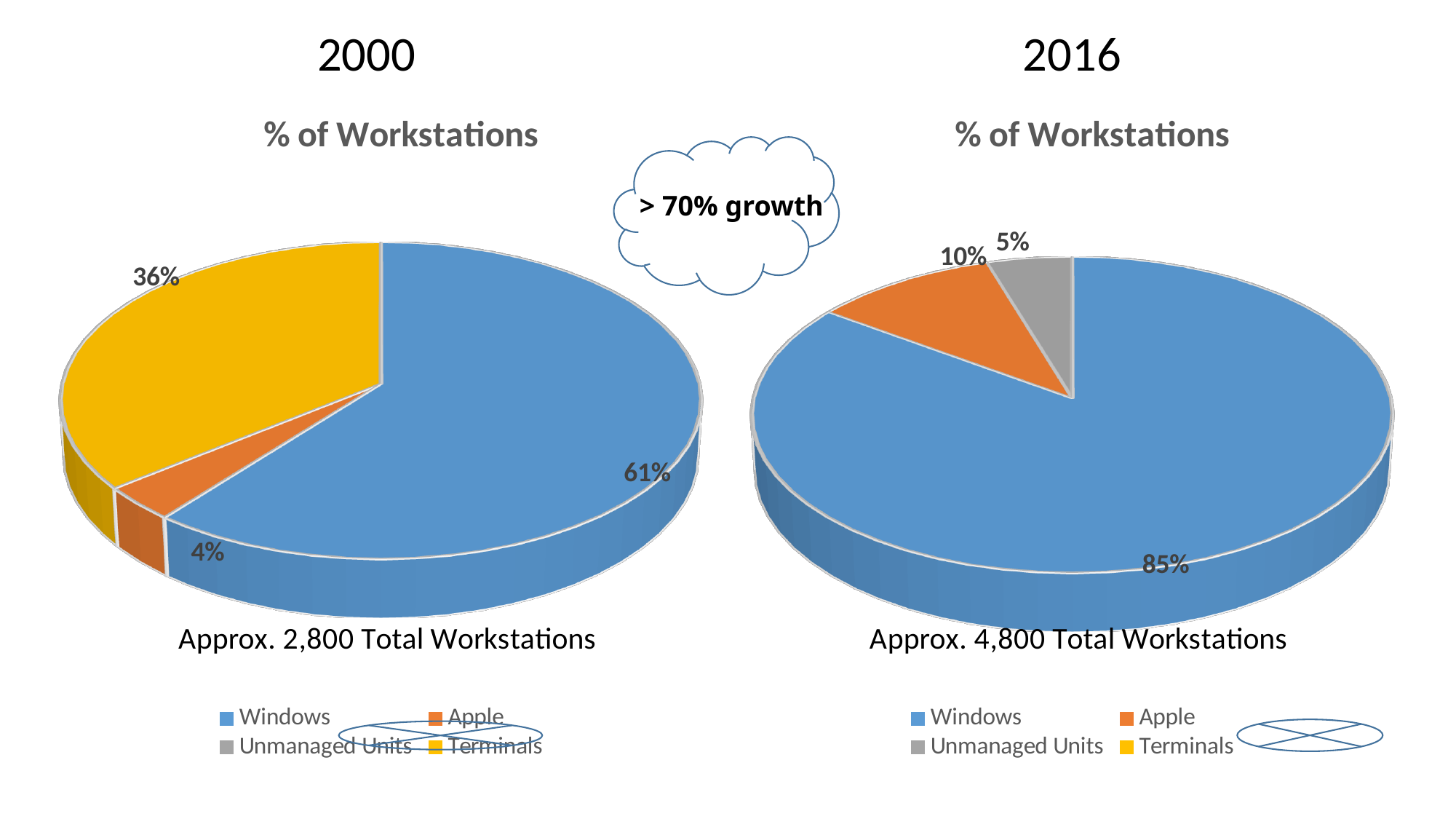
In the 2000 chart, what percentage of workstations is Windows? 61% In the 2000 chart, which category has the largest share? Windows How many entries does the legend of the 2016 chart list? 4 What type of chart is the 2000 chart? Pie chart What is the difference between the Windows share in the 2016 chart and the Windows share in the 2000 chart? 24 percentage points In the 2016 chart, what percentage of workstations is Apple? 10% In the 2000 chart, what percentage of workstations is Apple? 4% In the 2016 chart, which is larger, the Apple share or the Unmanaged Units share? Apple In the 2016 chart, what percentage of workstations is Windows? 85% In the 2000 chart, what percentage of workstations is Terminals? 36% In the 2016 chart, what percentage of workstations is Unmanaged Units? 5%